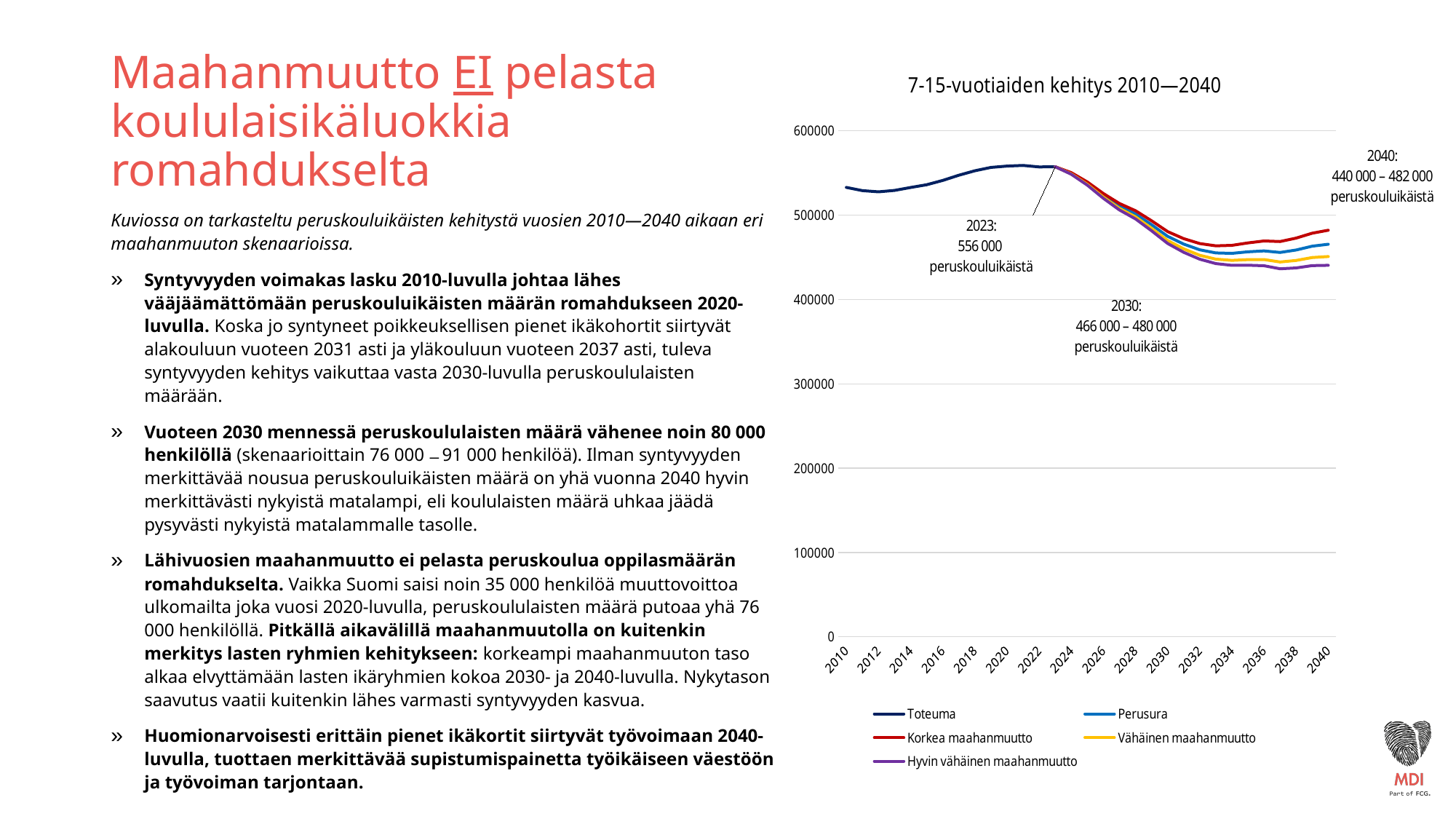
What kind of chart is shown on the slide? line chart According to the chart annotation, what range of peruskouluikäiset is given for 2030? 466 000 – 480 000 How many series does the chart legend list? 5 Which scenario series has the highest value in 2040? Korkea maahanmuutto Is the value of the Toteuma series in 2010 greater or less than 500000? greater Which scenario series has the lowest value in 2040? Hyvin vähäinen maahanmuutto According to the chart annotation, what range of peruskouluikäiset is given for 2040? 440 000 – 482 000 According to the chart annotation, how many peruskouluikäiset are there in 2023? 556 000 Is the value of the Hyvin vähäinen maahanmuutto series in 2040 greater or less than 500000? less Which series is drawn in red in the chart? Korkea maahanmuutto Between 2024 and 2034, do the series values rise or fall? fall What is the title of the chart? 7-15-vuotiaiden kehitys 2010—2040